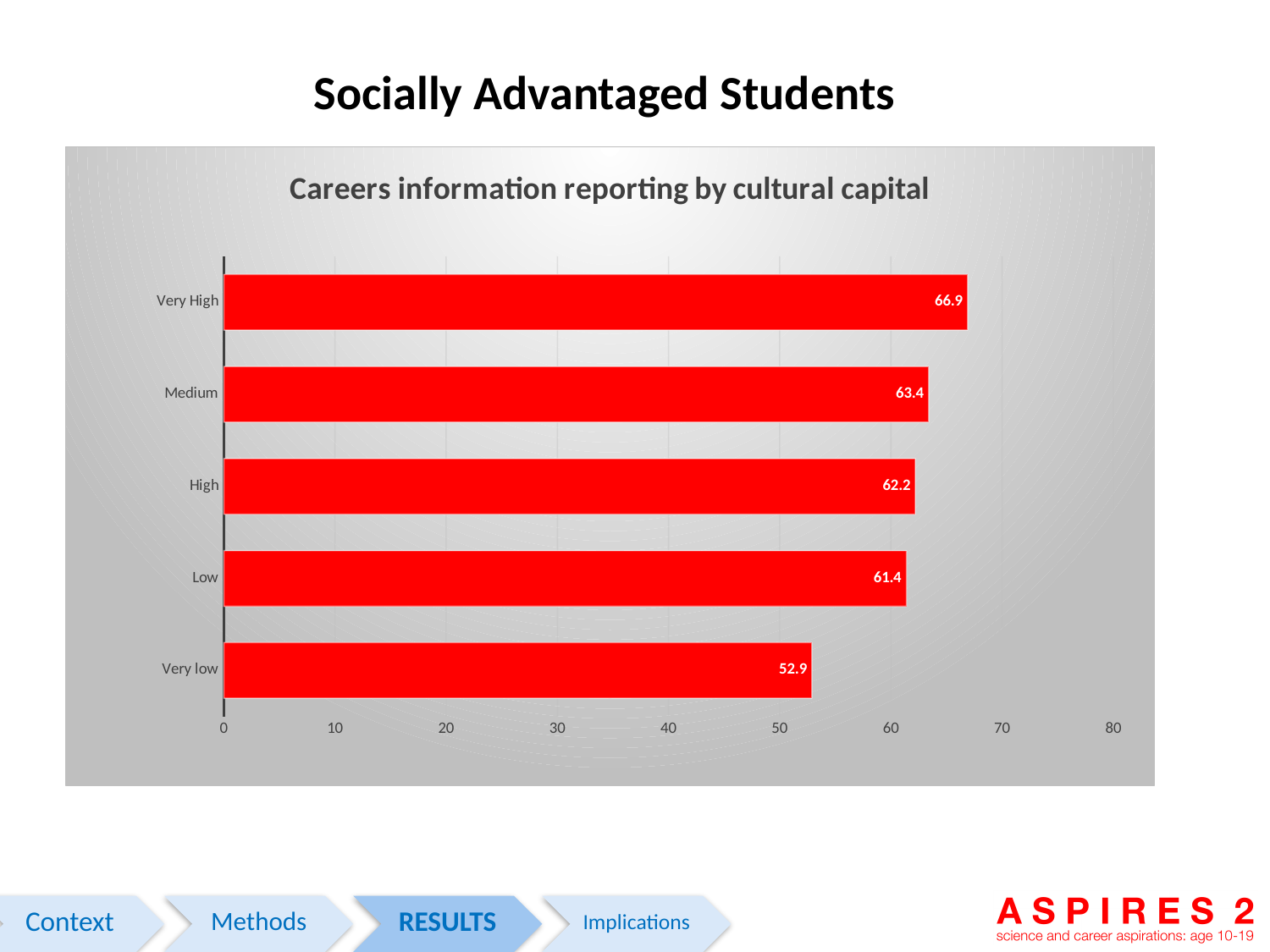
How many cultural capital categories are shown in the chart? 5 What is the difference between the values for Very High and Very low? 14 What is the value for Very low cultural capital? 52.9 Which is larger, the value for Low or the value for Very low? Low Is the value for High greater or less than 60? greater Which cultural capital category has the lowest value? Very low What kind of chart is shown on the slide? Bar chart Which cultural capital category has the highest value? Very High What is the value for Medium cultural capital? 63.4 What is the difference between the values for Medium and High? 1.2 What is the title of the chart? Careers information reporting by cultural capital What is the value for Very High cultural capital? 66.9